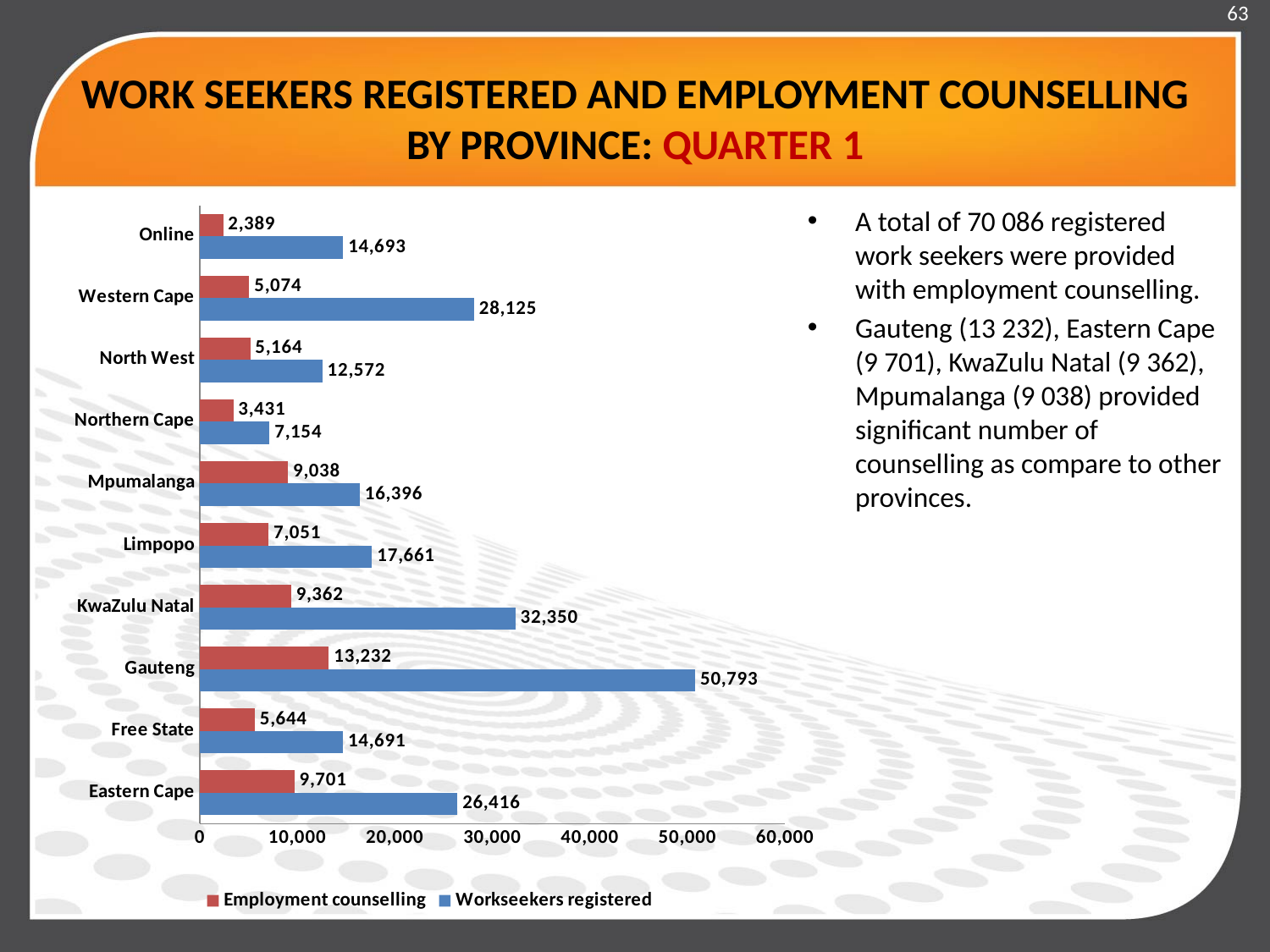
Which category has the lowest employment counselling value? Online Which category has the highest number of workseekers registered? Gauteng Which colour represents the Workseekers registered series? blue What is the difference between workseekers registered and employment counselling for Eastern Cape? 16,715 What is the number of workseekers registered for Gauteng? 50,793 How many categories are shown on the chart? 10 What is the number of workseekers registered for Western Cape? 28,125 Which has more workseekers registered, KwaZulu Natal or Western Cape? KwaZulu Natal How many series does the legend list? 2 Is the number of workseekers registered for Limpopo greater or less than 20,000? less What is the employment counselling value for Northern Cape? 3,431 What kind of chart is shown on the slide? bar chart